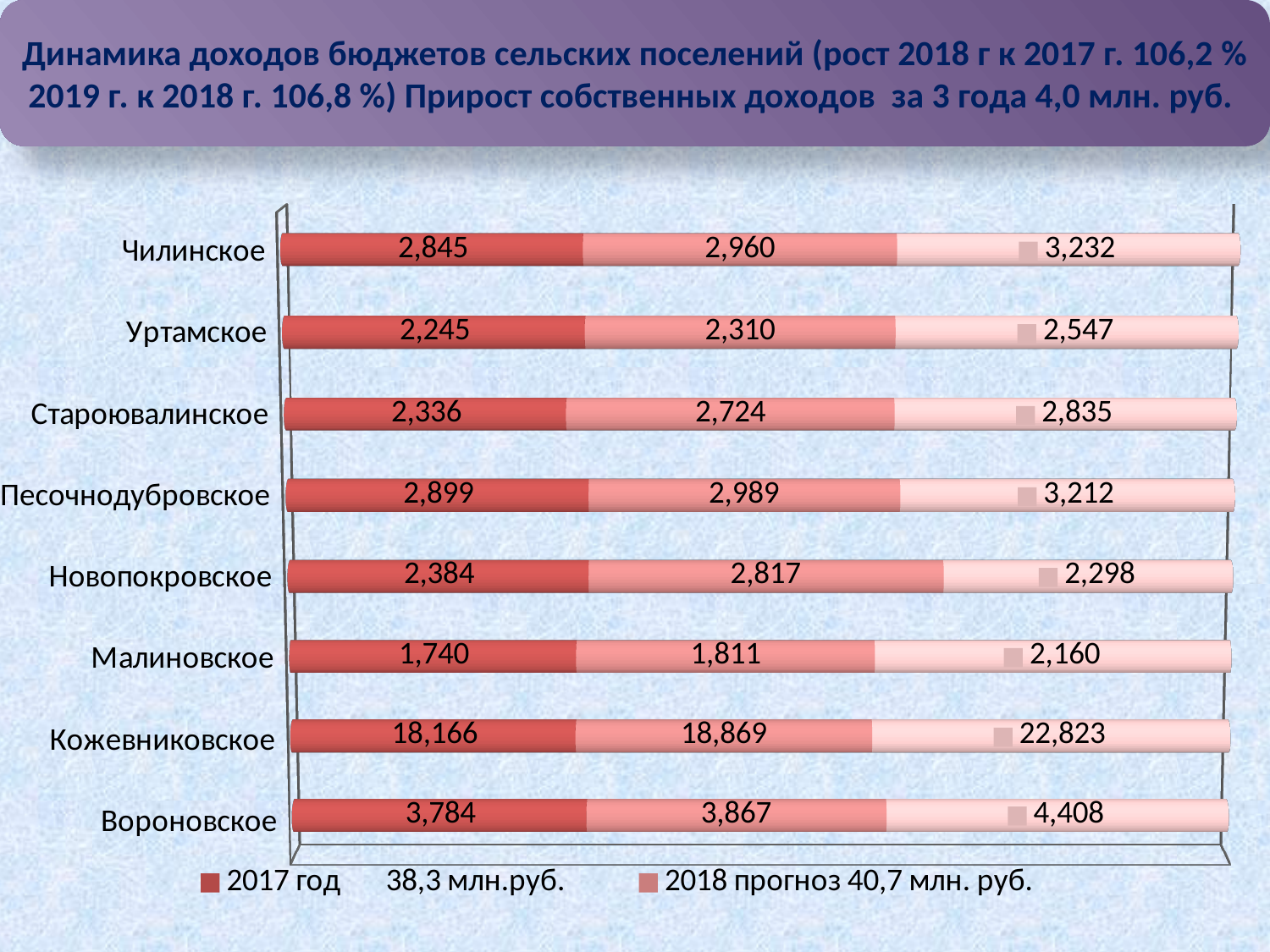
What kind of chart is shown on the slide? Stacked bar chart How many settlements are shown on the chart? 8 What is the 2018 прогноз value for Малиновское? 1,811 What is the total of the three segments in the Чилинское bar? 9,037 Which settlement has the highest 2017 год value? Кожевниковское What is the 2018 прогноз value for Кожевниковское? 18,869 Which is larger: the 2018 прогноз value for Новопокровское or for Староювалинское? Новопокровское How many series does the legend list? 2 What is the difference between the 2018 прогноз and 2017 год values for Кожевниковское? 0,703 What is the 2017 год value for Чилинское? 2,845 According to the legend, what total amount is given for 2017 год? 38,3 млн.руб. Which settlement has the lowest 2017 год value? Малиновское